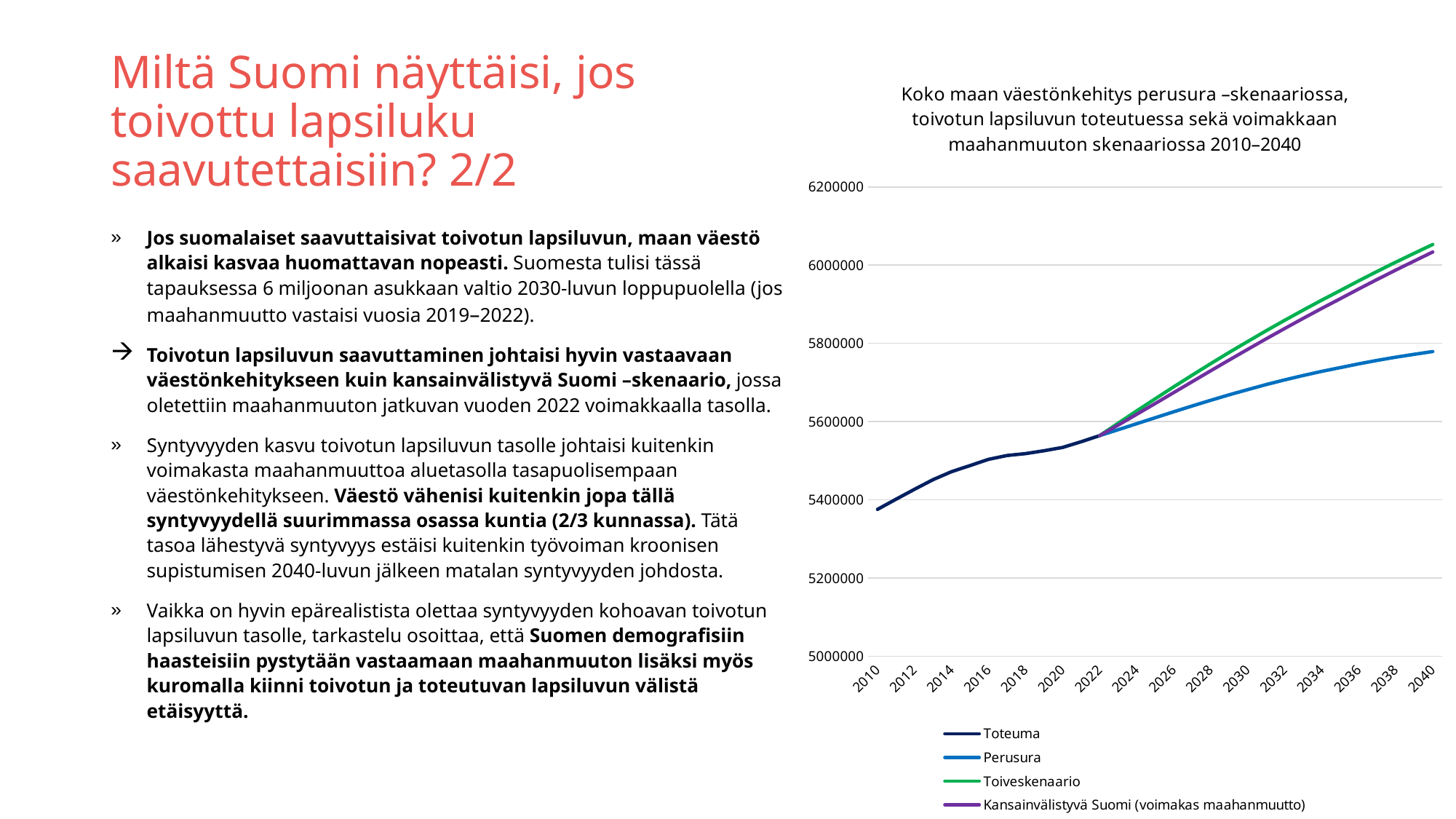
Is the value for Toiveskenaario in 2040 greater or less than 6000000? greater In 2040, which is larger: the value for Toiveskenaario or the value for Perusura? Toiveskenaario How many series does the legend list? 4 Is the value for Toteuma in 2010 greater or less than 5400000? less Is the value for Perusura in 2030 greater or less than 5600000? greater Does the Toteuma series rise or fall from 2010 to 2022? rise What is the title of the chart? Koko maan väestönkehitys perusura –skenaariossa, toivotun lapsiluvun toteutuessa sekä voimakkaan maahanmuuton skenaariossa 2010–2040 Which series is drawn in green? Toiveskenaario How many year labels are shown on the x axis? 16 What kind of chart is shown on the slide? line chart Which of the projected series has the lowest value in 2040? Perusura Which series has the highest value in 2040? Toiveskenaario